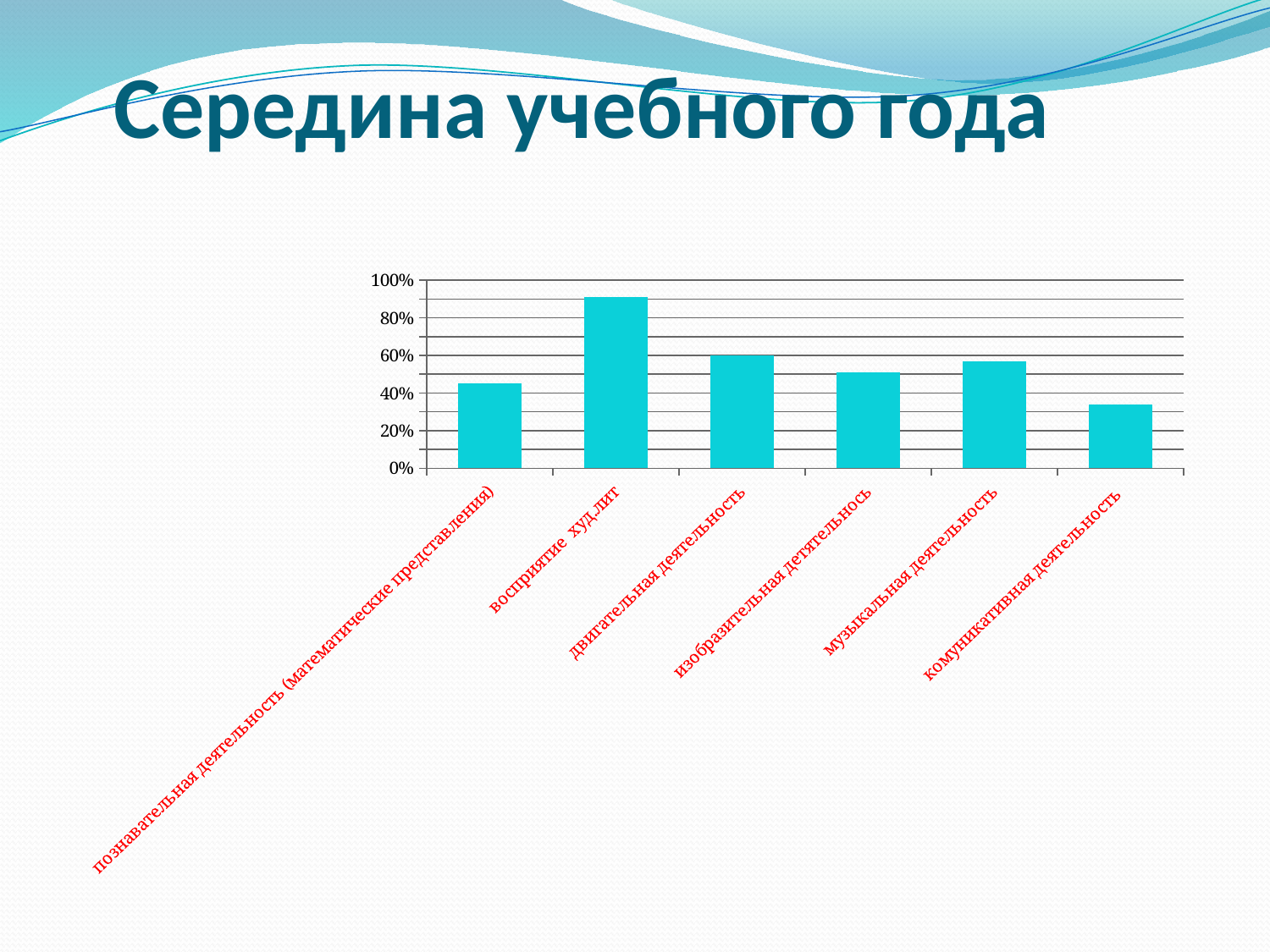
Which category has the highest bar in the chart? восприятие худ.лит Which is larger, the value for двигательная деятельность or the value for познавательная деятельность (математические представления)? двигательная деятельность Which category has the lowest bar in the chart? комуникативная деятельность Is the value for комуникативная деятельность greater or less than 40%? less Is the value for изобразительная деятельность greater or less than 60%? less Is the value for восприятие худ.лит greater or less than 80%? greater What is the title of the slide containing the chart? Середина учебного года Which is larger, the value for восприятие худ.лит or the value for комуникативная деятельность? восприятие худ.лит What kind of chart is shown on the slide? bar chart How many categories are plotted in the chart? 6